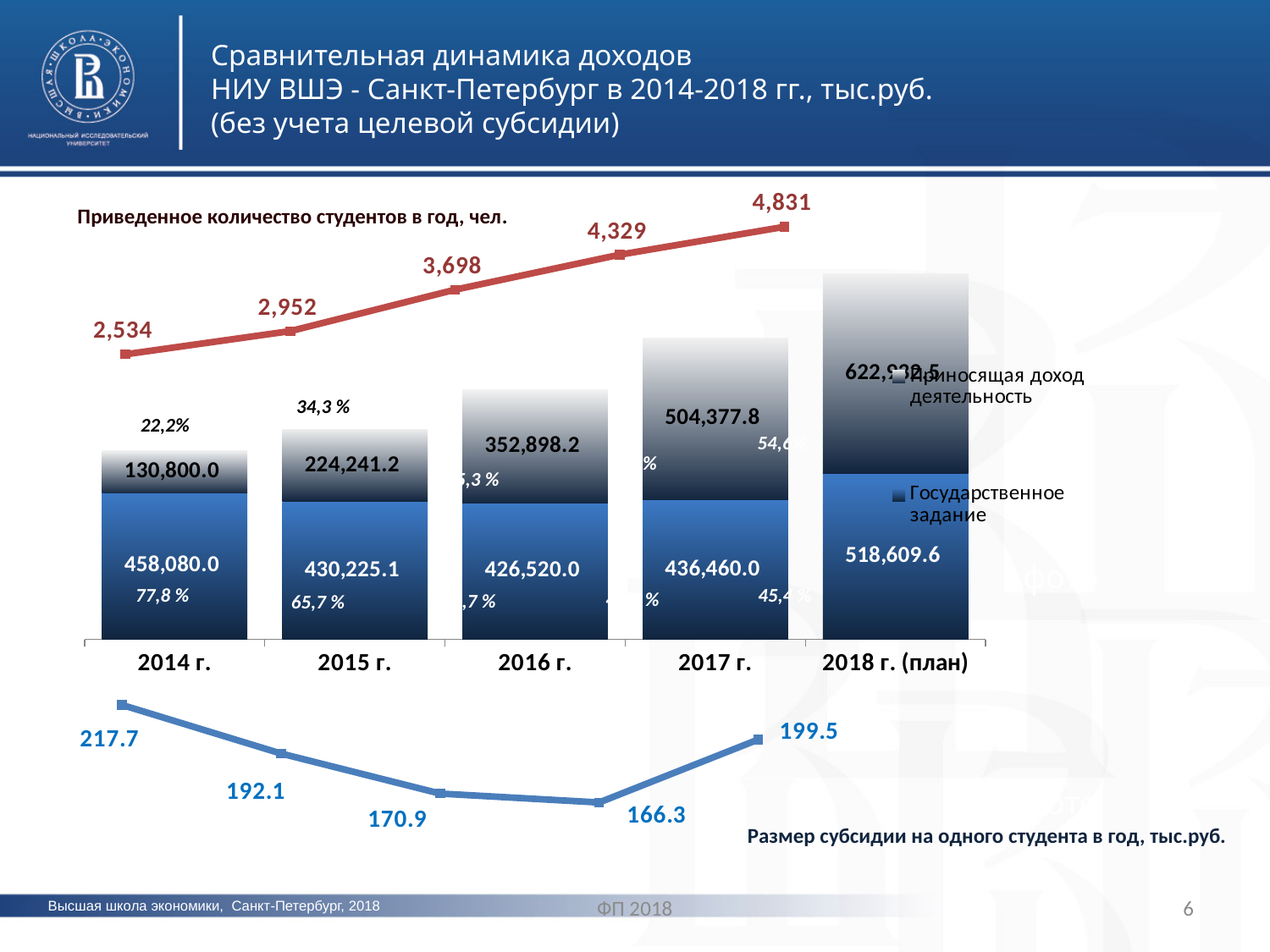
What is the value of Государственное задание for 2014 г.? 458,080.0 What is the difference between the Приносящая доход деятельность values for 2017 г. and 2016 г.? 151,479.6 Does the red line (Приведенное количество студентов в год, чел.) rise or fall from 2014 г. to 2018 г. (план)? rise By how much does the red line (Приведенное количество студентов) value for 2018 г. (план) exceed the value for 2014 г.? 2,297 Which is larger: Государственное задание for 2014 г. or Приносящая доход деятельность for 2014 г.? Государственное задание for 2014 г. What is the value of Государственное задание for 2018 г. (план)? 518,609.6 What is the value of Приносящая доход деятельность for 2017 г.? 504,377.8 How many years (categories) are shown on the x axis of the bar chart? 5 On the red line (Приведенное количество студентов в год, чел.), which year has the highest value? 2018 г. (план) On the blue line (Размер субсидии на одного студента в год, тыс.руб.), which year has the lowest value? 2017 г. On the red line (Приведенное количество студентов в год, чел.), what is the value for 2016 г.? 3,698 What is the total of the stacked bar for 2014 г.? 588,880.0